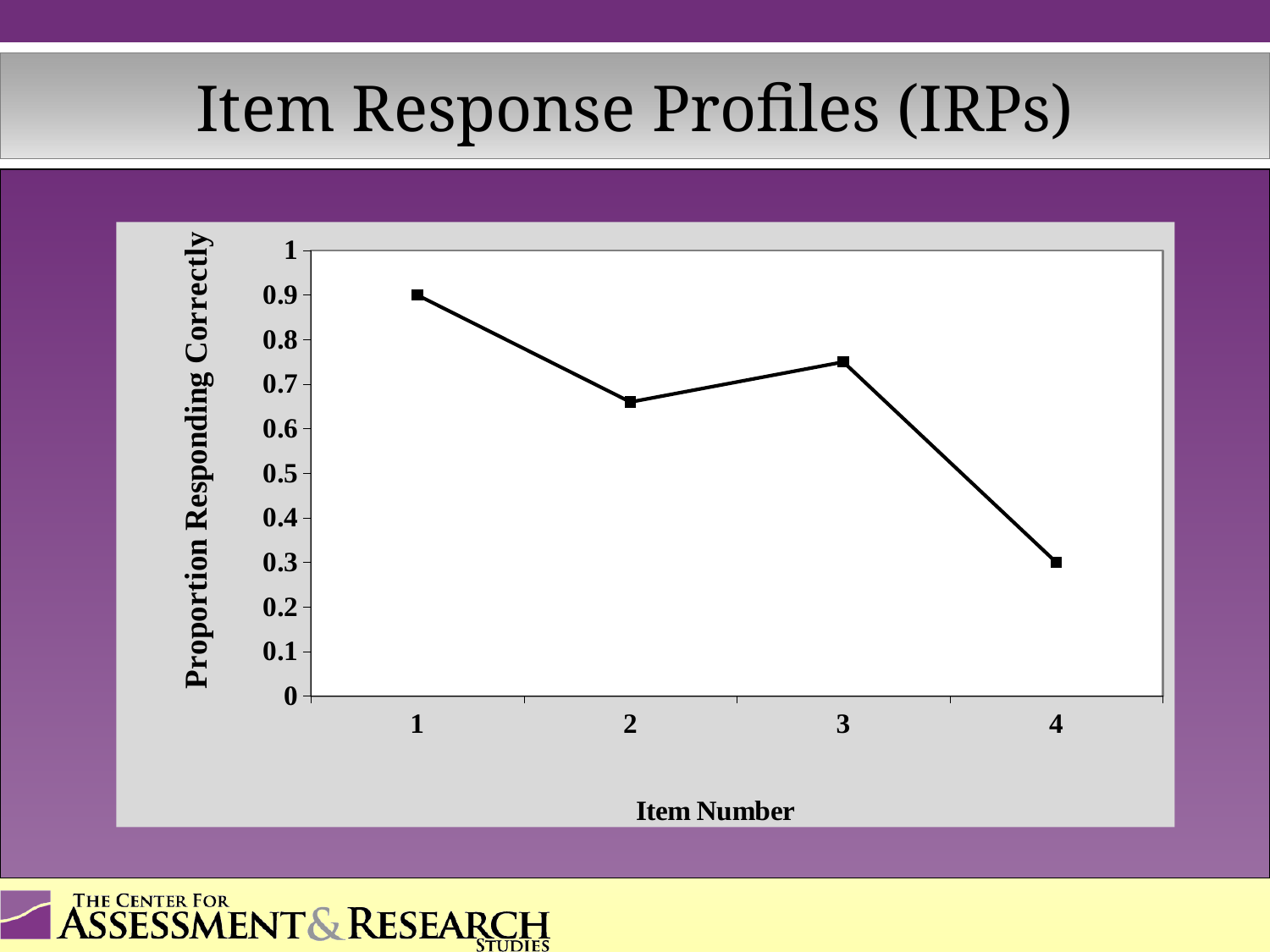
What is the proportion responding correctly for item 1? 0.9 Is the proportion responding correctly for item 2 greater or less than 0.7? less How many item numbers are plotted on the x axis? 4 Which item number has the highest proportion responding correctly? 1 What is the label of the x axis? Item Number What is the difference between the proportion responding correctly for item 1 and item 4? 0.6 Which item number has the lowest proportion responding correctly? 4 What kind of chart is shown on the slide? line chart Is the proportion responding correctly for item 2 greater or less than 0.6? greater Is the proportion responding correctly for item 3 greater or less than 0.7? greater What is the proportion responding correctly for item 4? 0.3 Which has a higher proportion responding correctly, item 2 or item 3? item 3